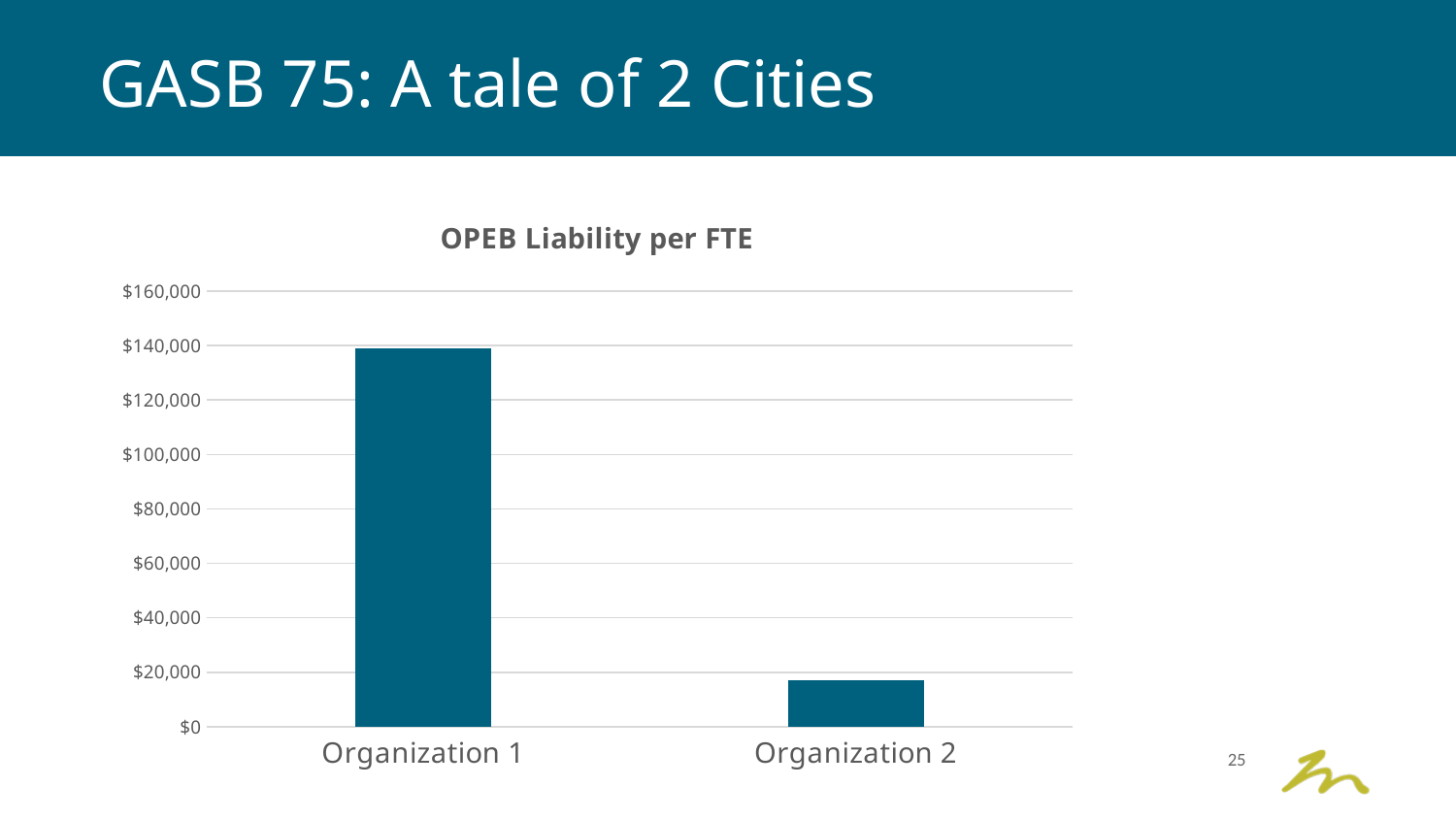
Which organization has the lowest OPEB liability per FTE? Organization 2 Do the values rise or fall from Organization 1 to Organization 2? fall How many organizations are shown on the chart? 2 What is the title of the chart? OPEB Liability per FTE Is the value for Organization 2 greater or less than $20,000? less Which organization has the highest OPEB liability per FTE? Organization 1 What is the highest value shown on the vertical axis? $160,000 What kind of chart is shown on the slide? bar chart Is the value for Organization 1 greater or less than $120,000? greater Which is larger, the value for Organization 1 or Organization 2? Organization 1